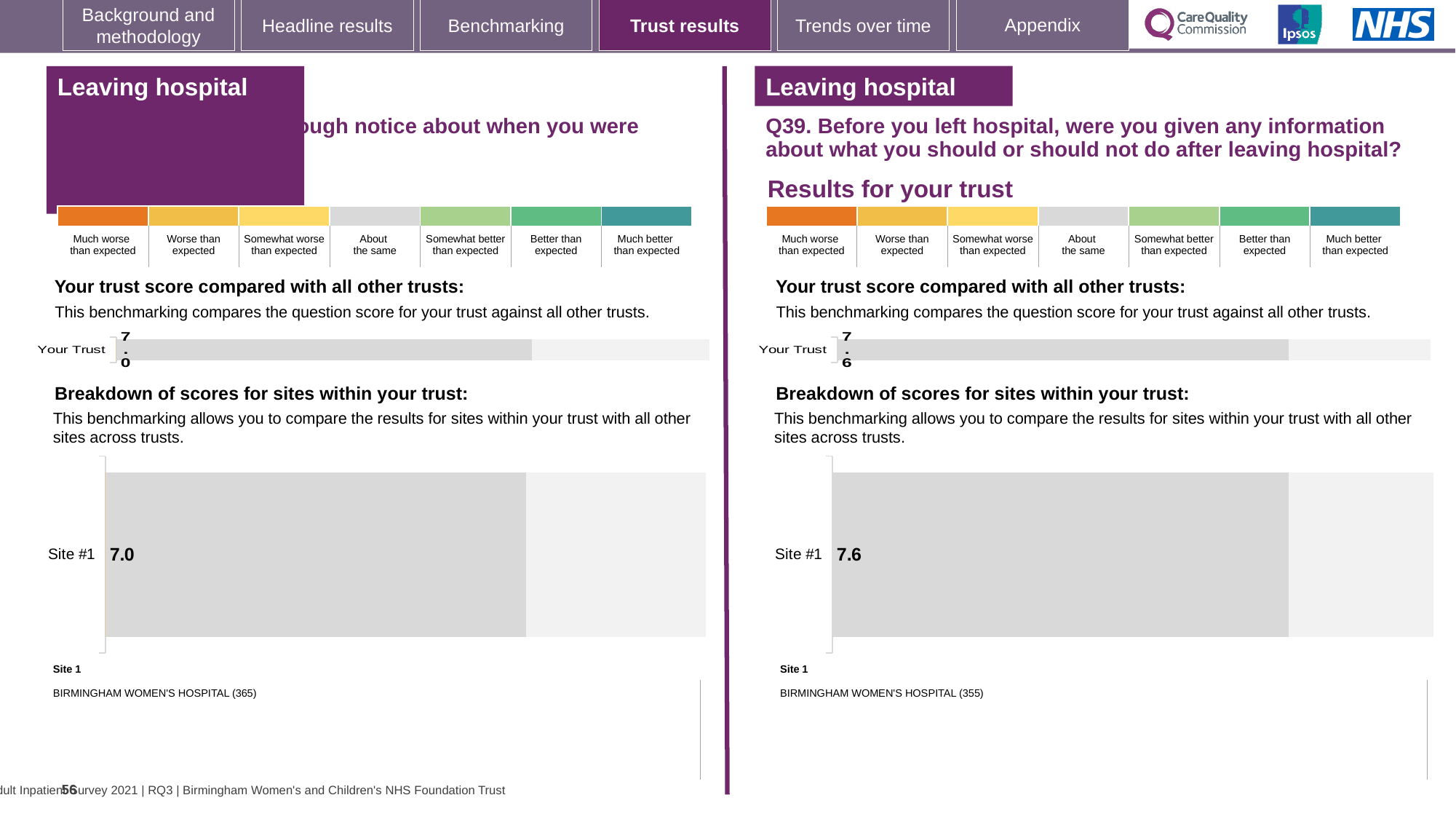
Is the Site #1 score on the right-hand chart greater or less than 7.0? greater What kind of chart is used to show the Site #1 score on the right-hand side of the slide? Bar chart On the right-hand 'Breakdown of scores for sites within your trust' chart, what is the score for Site #1? 7.6 Which is larger: the Site #1 score on the left-hand chart or the Site #1 score on the right-hand chart? The right-hand chart (7.6) On the right-hand chart for Q39, what is the score shown for Your Trust? 7.6 On the left-hand side, which site is listed as Site 1 below the breakdown chart? BIRMINGHAM WOMEN'S HOSPITAL (365) How many sites are shown in the right-hand 'Breakdown of scores for sites within your trust' chart? 1 On the left-hand 'Breakdown of scores for sites within your trust' chart, what is the score for Site #1? 7.0 On the left-hand chart, what is the score shown for Your Trust? 7.0 On the right-hand side, which site is listed as Site 1 below the breakdown chart? BIRMINGHAM WOMEN'S HOSPITAL (355) What is the difference between the Your Trust score on the right-hand chart (Q39) and the Your Trust score on the left-hand chart? 0.6